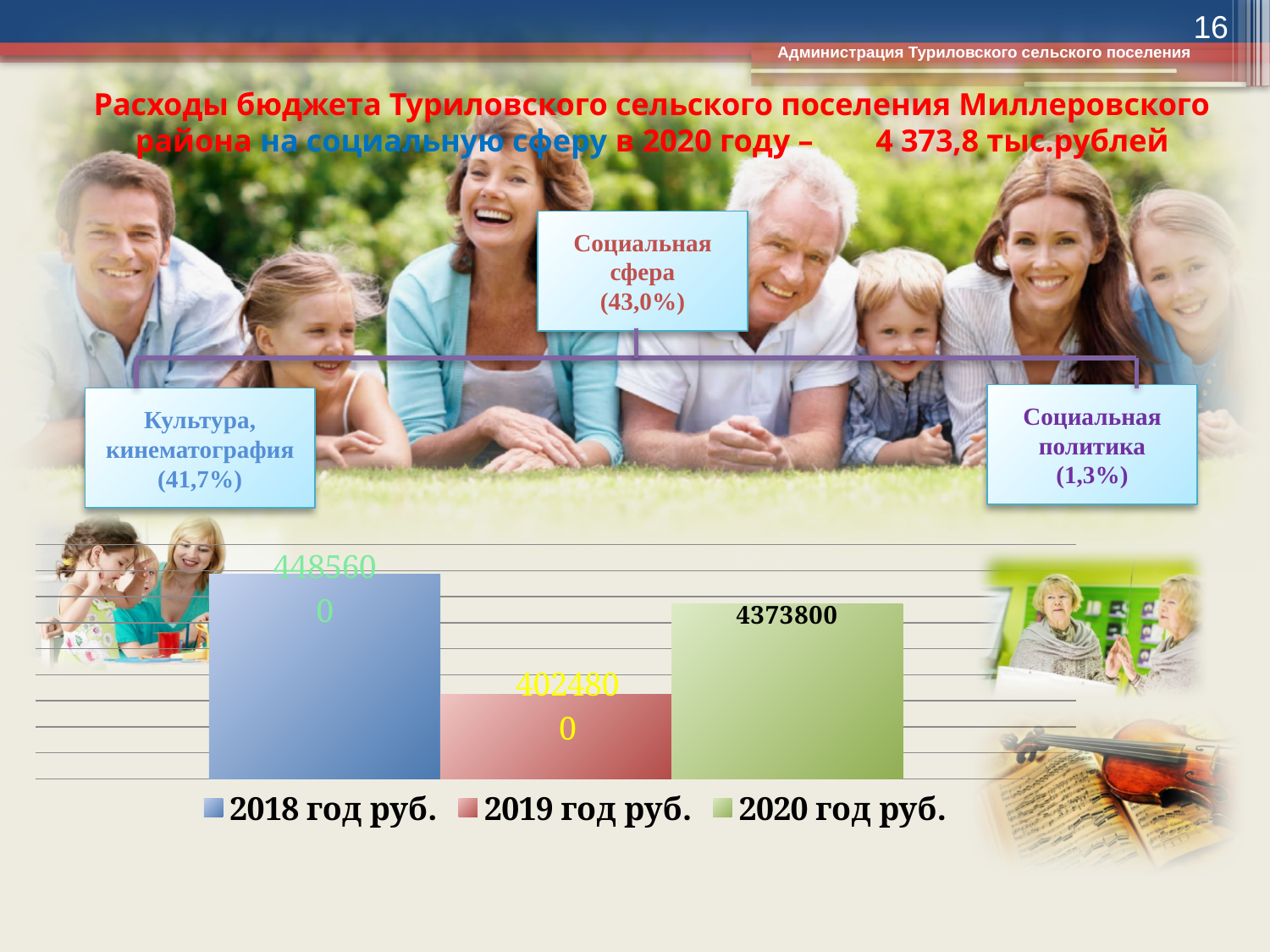
What is the difference between the 2020 год руб. and 2019 год руб. values? 349000 What value is shown for the 2019 год руб. bar? 4024800 Which year has the lowest value in the chart? 2019 год руб. What colour is the 2019 год руб. bar? red What value is shown for the 2018 год руб. bar? 4485600 How many series does the legend list? 3 What colour is the 2020 год руб. bar? green What is the difference between the 2018 год руб. and 2019 год руб. values? 460800 Which year has the highest value in the chart? 2018 год руб. Which is larger, the 2018 год руб. value or the 2020 год руб. value? 2018 год руб. What kind of chart is shown on the slide? bar chart What value is shown for the 2020 год руб. bar? 4373800